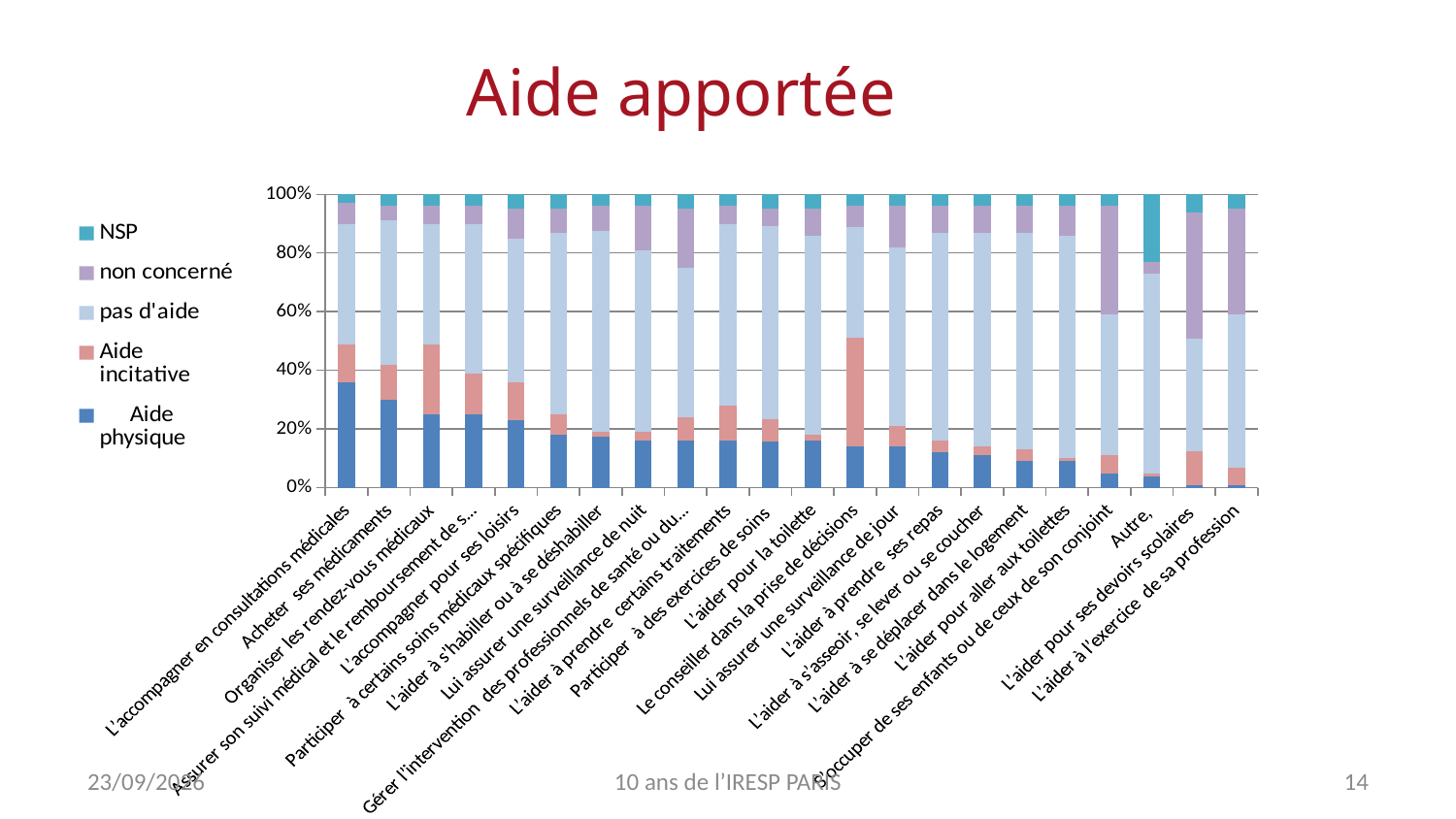
What is the highest value shown on the y axis? 100% Which has the larger 'Aide physique' share: 'Organiser les rendez-vous médicaux' or 'L'aider pour la toilette'? Organiser les rendez-vous médicaux Is the 'Aide physique' value for 'Autre' greater or less than 20%? less How many categories (bars) are plotted along the x axis? 22 How many series does the legend list? 5 Which category has the largest 'NSP' share? Autre What kind of chart is shown on the slide? stacked bar chart Is the 'Aide physique' value for 'L'aider pour aller aux toilettes' greater or less than 20%? less Which category has the largest 'Aide physique' share? L'accompagner en consultations médicales What is the title of the chart? Aide apportée Is the 'Aide physique' value for 'L'accompagner en consultations médicales' greater or less than 20%? greater Which category has the largest 'Aide incitative' share? Le conseiller dans la prise de décisions